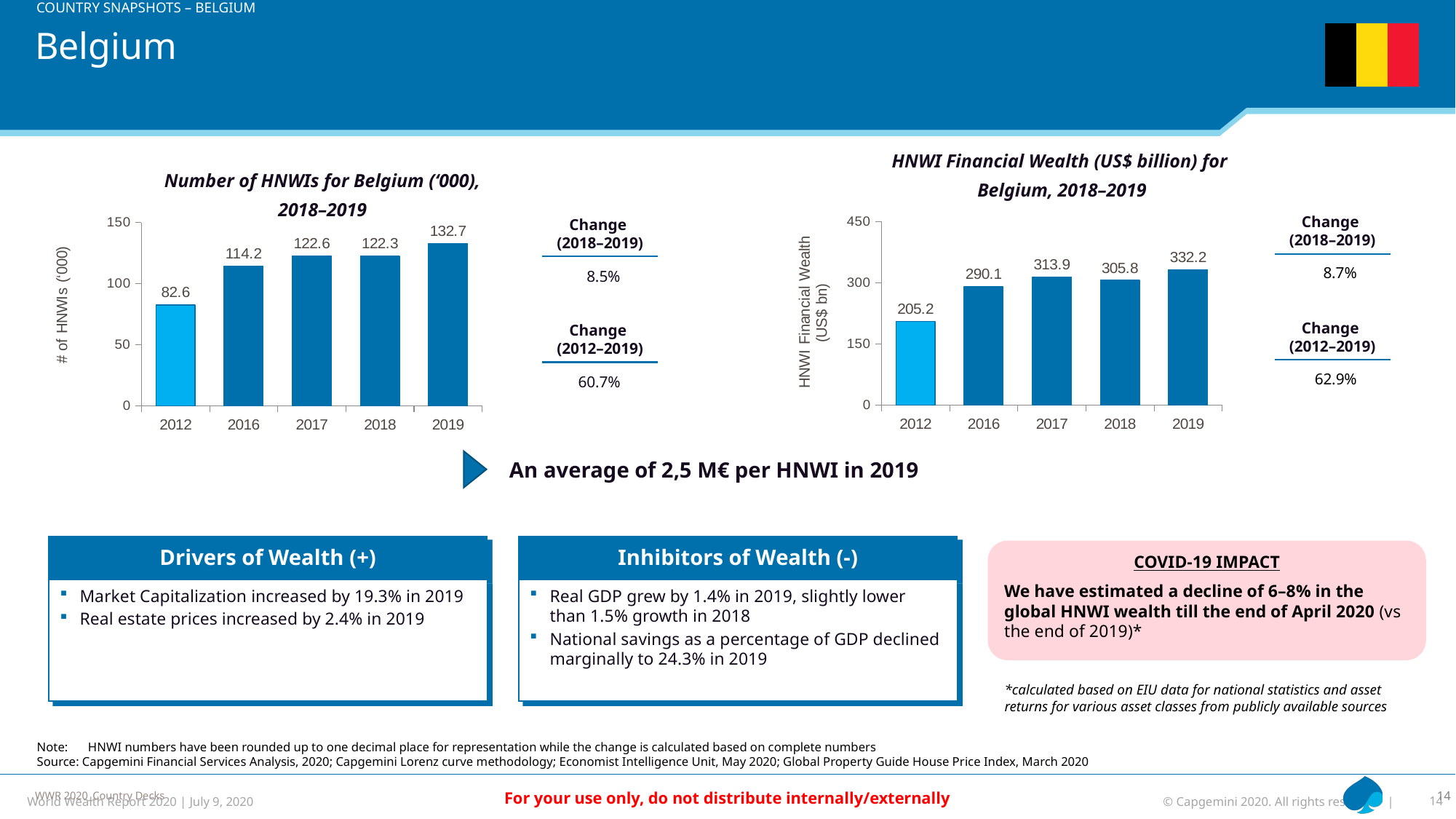
In the 'Number of HNWIs for Belgium' chart, what is the value for 2019? 132.7 In the 'HNWI Financial Wealth' chart, what is the difference between the 2019 and 2012 values? 127.0 In the 'HNWI Financial Wealth' chart, what is the value for 2017? 313.9 What type of chart is the 'HNWI Financial Wealth' chart? Bar chart In the 'Number of HNWIs for Belgium' chart, what is the value for 2012? 82.6 In the 'HNWI Financial Wealth' chart, which year has the highest value? 2019 In the 'HNWI Financial Wealth' chart, is the value for 2016 greater or less than 300? less In the 'Number of HNWIs for Belgium' chart, what is the difference between the 2019 and 2018 values? 10.4 In the 'HNWI Financial Wealth' chart, what is the value for 2012? 205.2 In the 'Number of HNWIs for Belgium' chart, which is larger, the value for 2017 or the value for 2018? 2017 How many years are shown in the 'Number of HNWIs for Belgium' chart? 5 In the 'Number of HNWIs for Belgium' chart, which year has the lowest value? 2012